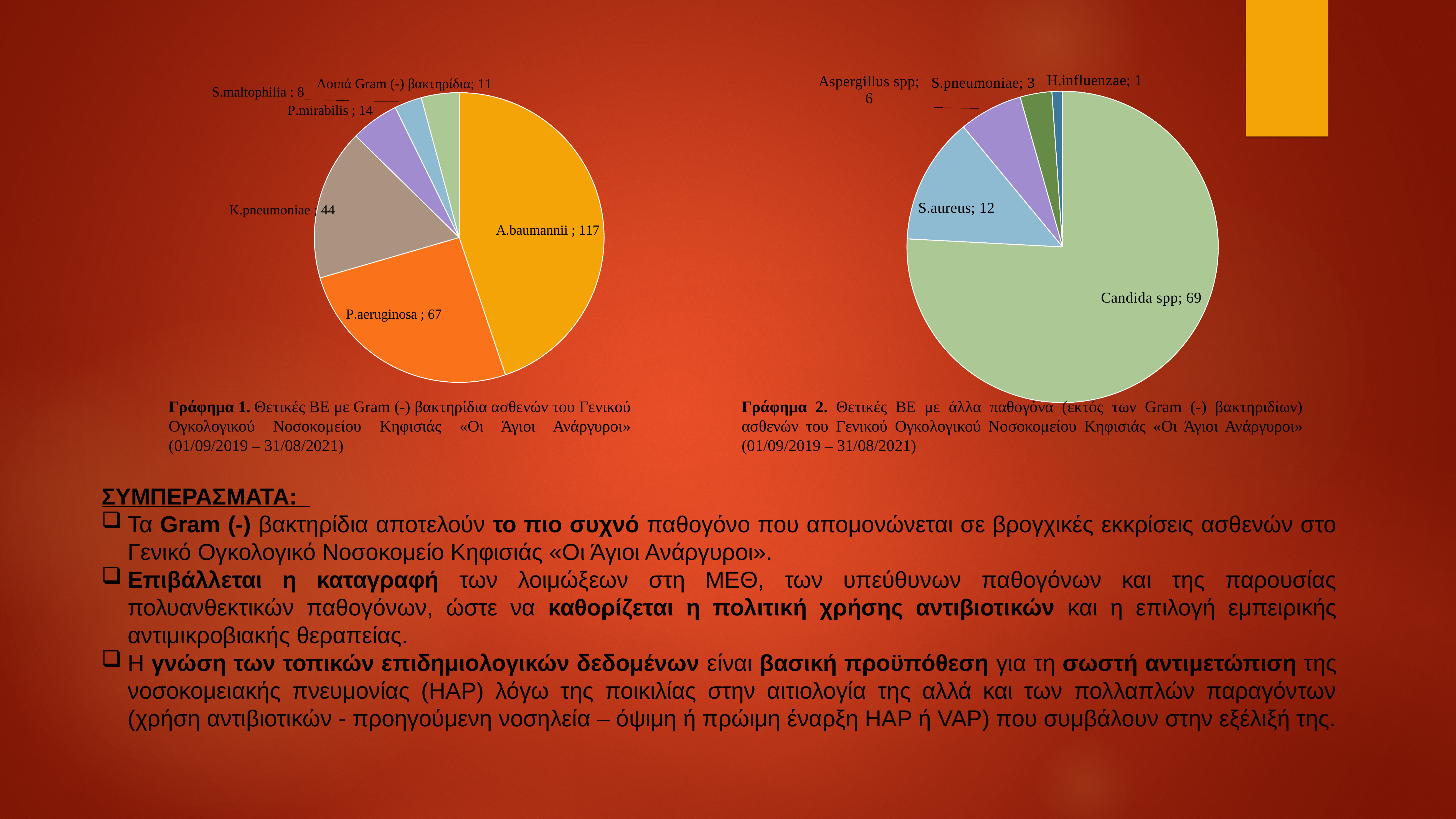
In the left pie chart (Γράφημα 1), which is larger: P.mirabilis or Λοιπά Gram (-) βακτηρίδια? P.mirabilis What type of chart is Γράφημα 1? Pie chart How many slices does the right pie chart (Γράφημα 2) have? 5 In the left pie chart (Γράφημα 1), which category has the smallest value? S.maltophilia In the right pie chart (Γράφημα 2), which category has the largest value? Candida spp In the left pie chart (Γράφημα 1), what is the value for K.pneumoniae? 44 How many slices does the left pie chart (Γράφημα 1) have? 6 In the right pie chart (Γράφημα 2), what is the value for S.aureus? 12 In the right pie chart (Γράφημα 2), what is the difference between the values for Aspergillus spp and S.pneumoniae? 3 In the left pie chart (Γράφημα 1), what is the difference between the values for A.baumannii and P.aeruginosa? 50 In the left pie chart (Γράφημα 1), what is the value for A.baumannii? 117 In the right pie chart (Γράφημα 2), what is the value for H.influenzae? 1